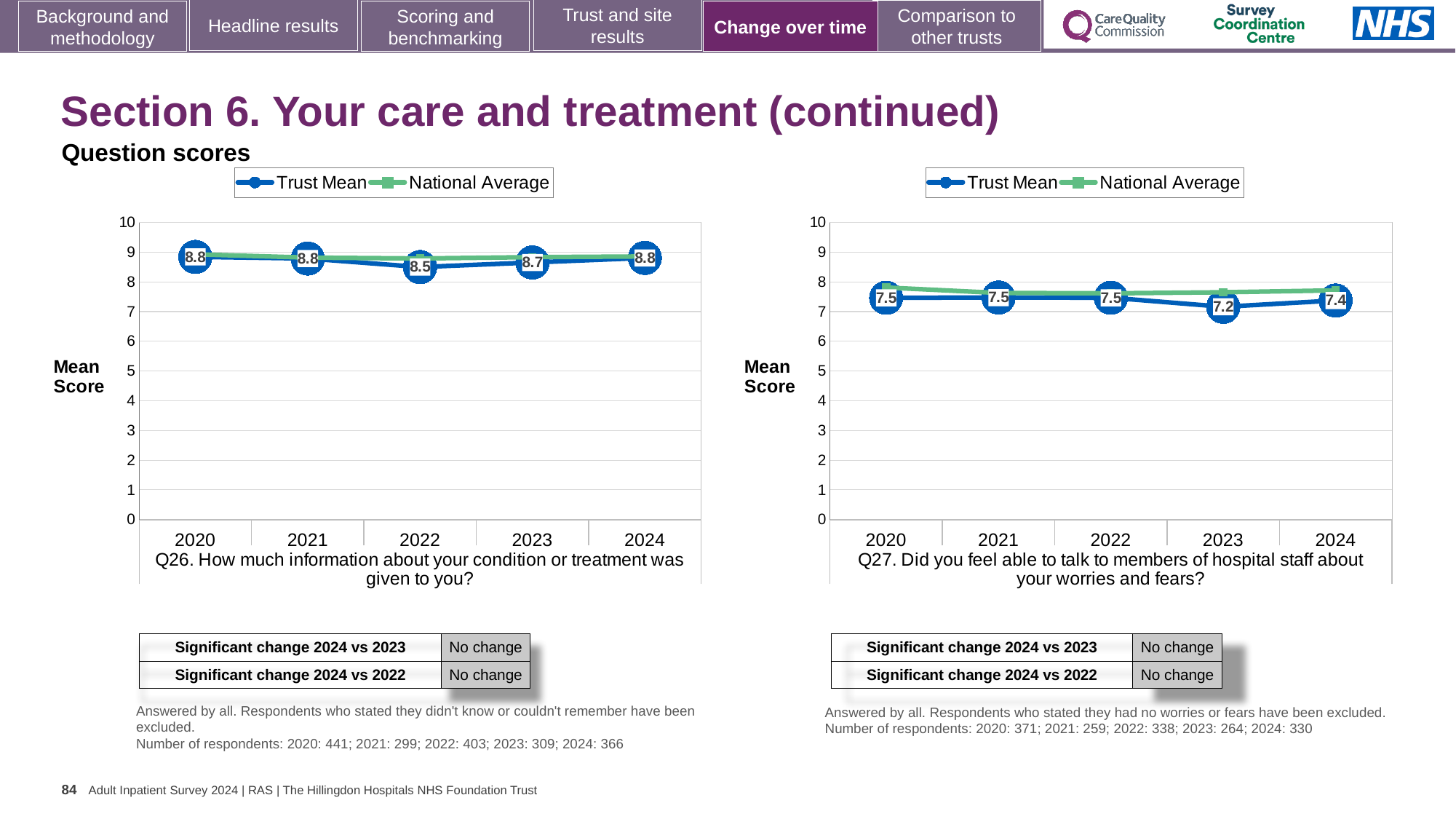
On the Q26 chart (left), what is the Trust Mean score for 2022? 8.5 How many series does the legend of the Q26 chart (left) list? 2 How many years are plotted on the Q27 chart (right)? 5 On the Q27 chart (right), is the National Average value for 2020 greater or less than 7? greater On the Q27 chart (right), what is the difference between the Trust Mean scores for 2022 and 2023? 0.3 What kind of chart is the Q26 chart (left)? Line chart On the Q26 chart (left), which year has the lowest Trust Mean score? 2022 On the Q26 chart (left), does the Trust Mean score rise or fall from 2022 to 2024? Rise On the Q27 chart (right), which year has the lowest Trust Mean score? 2023 On the Q26 chart (left), what is the difference between the Trust Mean scores for 2021 and 2022? 0.3 On the Q26 chart (left), which year has the larger Trust Mean score, 2022 or 2023? 2023 On the Q27 chart (right), what is the Trust Mean score for 2023? 7.2